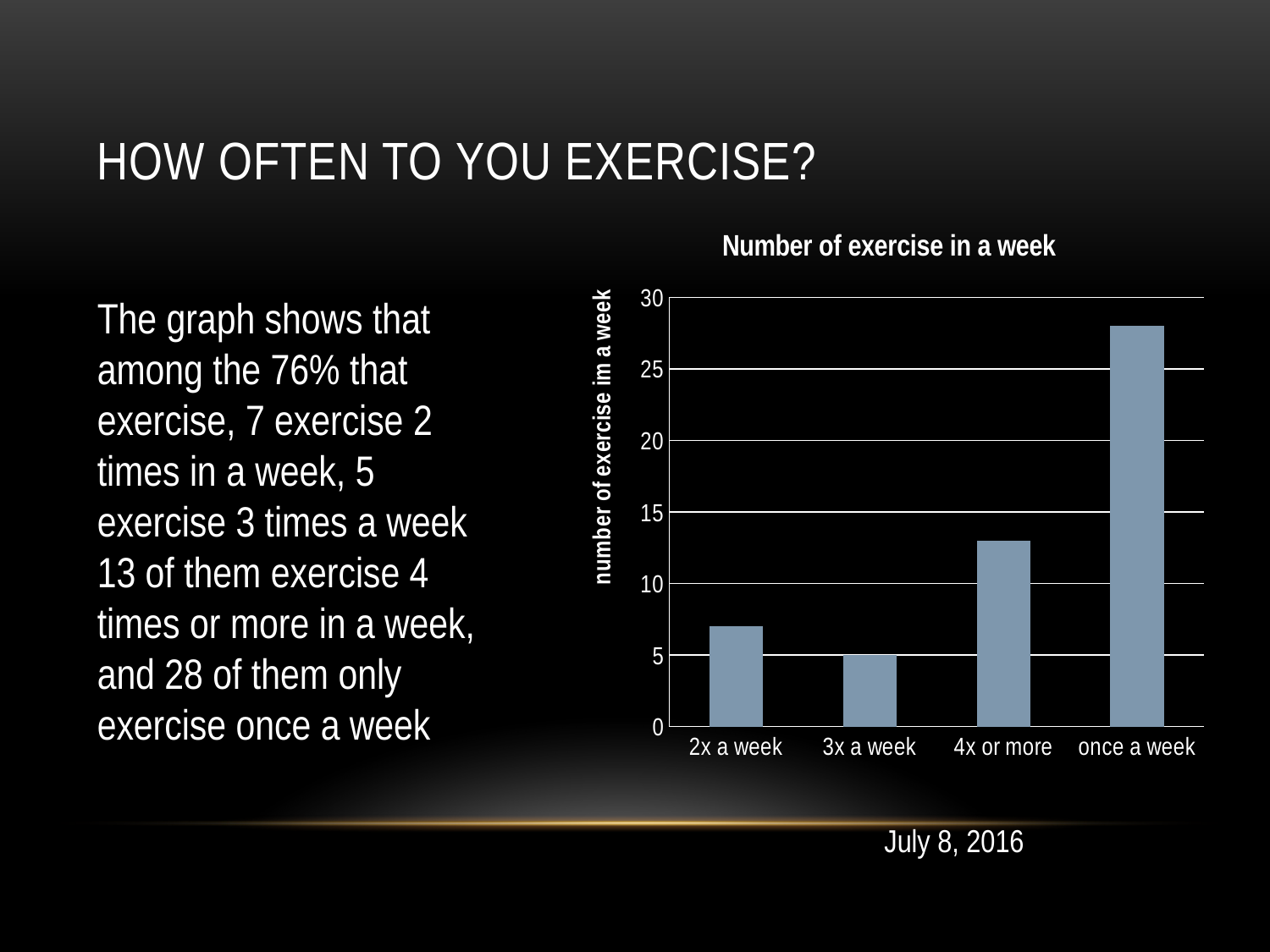
What type of chart is shown on the slide? bar chart What is the value for once a week? 28 Which category has the highest bar in the chart? once a week Is the value for 4x or more greater or less than 10? greater What is the difference between the value for once a week and the value for 3x a week? 23 Is the value for once a week greater or less than 25? greater Which category has the lowest bar in the chart? 3x a week Which is larger, the value for 4x or more or the value for 2x a week? 4x or more What is the value for 3x a week? 5 What is the title of the chart? Number of exercise in a week How many categories are shown on the x axis of the chart? 4 Is the value for 2x a week greater or less than 10? less